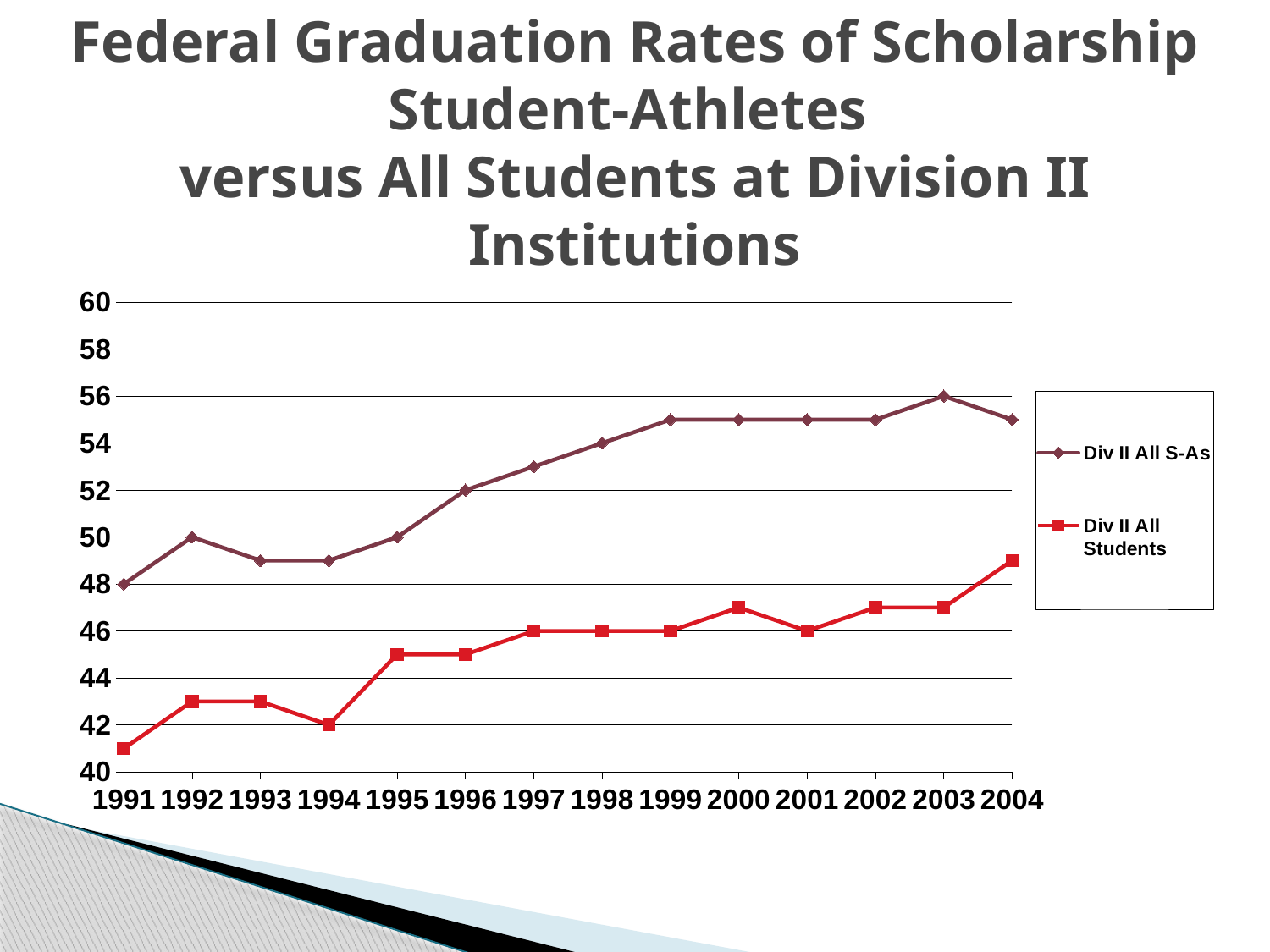
In 1999, which series has the higher value, Div II All S-As or Div II All Students? Div II All S-As What is the difference between the Div II All S-As value in 2003 and in 1991? 8 In which year is the Div II All S-As series at its highest? 2003 In which year is the Div II All Students series at its lowest? 1991 Overall, does the Div II All Students series rise or fall from 1991 to 2004? rise Is the value for Div II All Students in 2004 greater or less than 48? greater What is the value for Div II All S-As in 1991? 48 What type of chart is shown on the slide? line chart What is the value for Div II All S-As in 2003? 56 How many series does the legend list? 2 What is the value for Div II All Students in 1994? 42 How many years are plotted along the x axis? 14